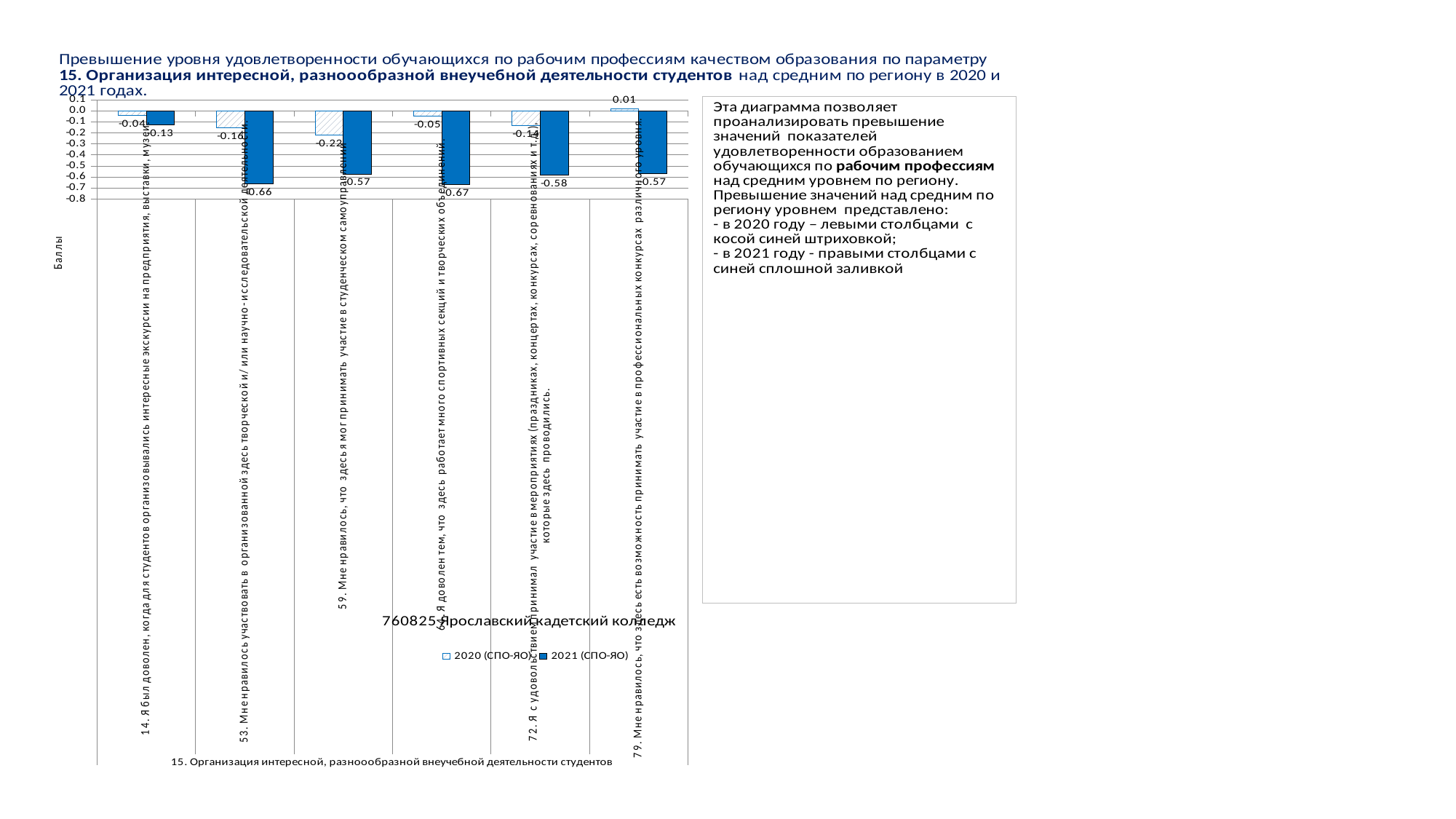
For item 14, which is larger: the 2020 (СПО-ЯО) value or the 2021 (СПО-ЯО) value? 2020 (СПО-ЯО) How many items (categories) are shown on the x axis of the chart? 6 Which item has the lowest 2021 (СПО-ЯО) value? Item 64 (Я доволен тем, что здесь работает много спортивных секций и творческих объединений), -0.67 What is the 2021 (СПО-ЯО) value for item 53 (Мне нравилось участвовать в организованной здесь творческой и/или научно-исследовательской деятельности)? -0.66 How many series does the chart legend list? 2 What is the 2020 (СПО-ЯО) value for item 59 (Мне нравилось, что здесь я мог принимать участие в студенческом самоуправлении)? -0.22 What is the 2021 (СПО-ЯО) value for item 72 (Я с удовольствием принимал участие в мероприятиях, которые здесь проводились)? -0.58 What type of chart is shown on the slide? Bar chart What is the 2020 (СПО-ЯО) value for item 79 (Мне нравилось, что здесь есть возможность принимать участие в профессиональных конкурсах различного уровня)? 0.01 Which item has the lowest 2020 (СПО-ЯО) value? Item 59 (Мне нравилось, что здесь я мог принимать участие в студенческом самоуправлении), -0.22 Which item has the highest 2021 (СПО-ЯО) value? Item 14 (Я был доволен, когда для студентов организовывались интересные экскурсии на предприятия, выставки, музеи), -0.13 What is the difference between the 2020 (СПО-ЯО) and 2021 (СПО-ЯО) values for item 53? 0.50